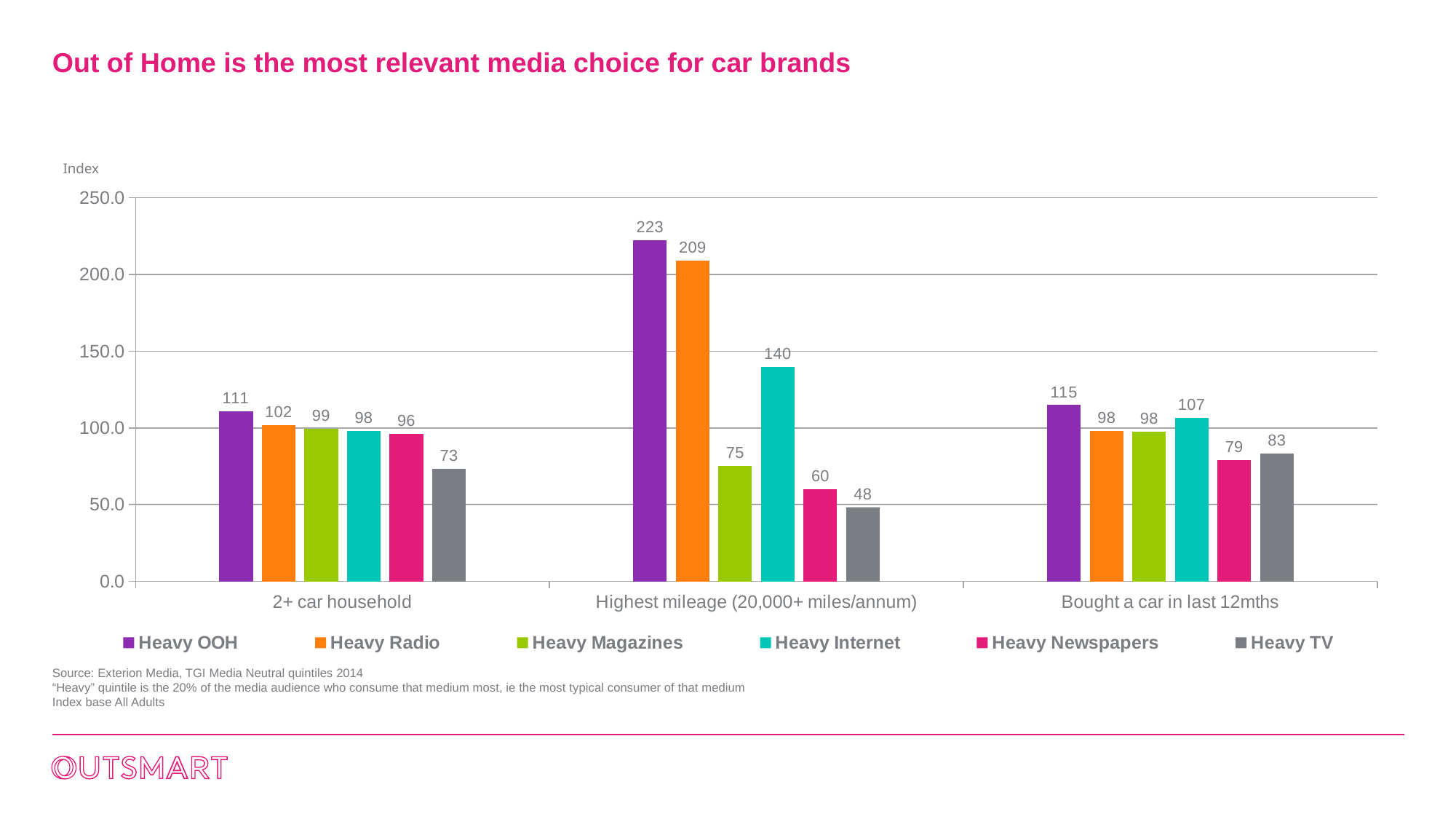
How many categories are shown on the x axis? 3 What is the Heavy OOH index for Highest mileage (20,000+ miles/annum)? 223 What is the title of the slide? Out of Home is the most relevant media choice for car brands Which series has the highest index for Highest mileage (20,000+ miles/annum)? Heavy OOH Which series has the lowest index for Bought a car in last 12mths? Heavy Newspapers What is the Heavy TV index for 2+ car household? 73 Which is larger for 2+ car household: Heavy OOH or Heavy TV? Heavy OOH What kind of chart is shown on the slide? Bar chart Is the Heavy Internet value for Highest mileage (20,000+ miles/annum) greater or less than 100? greater How many series does the legend list? 6 What is the Heavy Internet index for Bought a car in last 12mths? 107 What is the difference between the Heavy OOH and Heavy Radio index for Highest mileage (20,000+ miles/annum)? 14